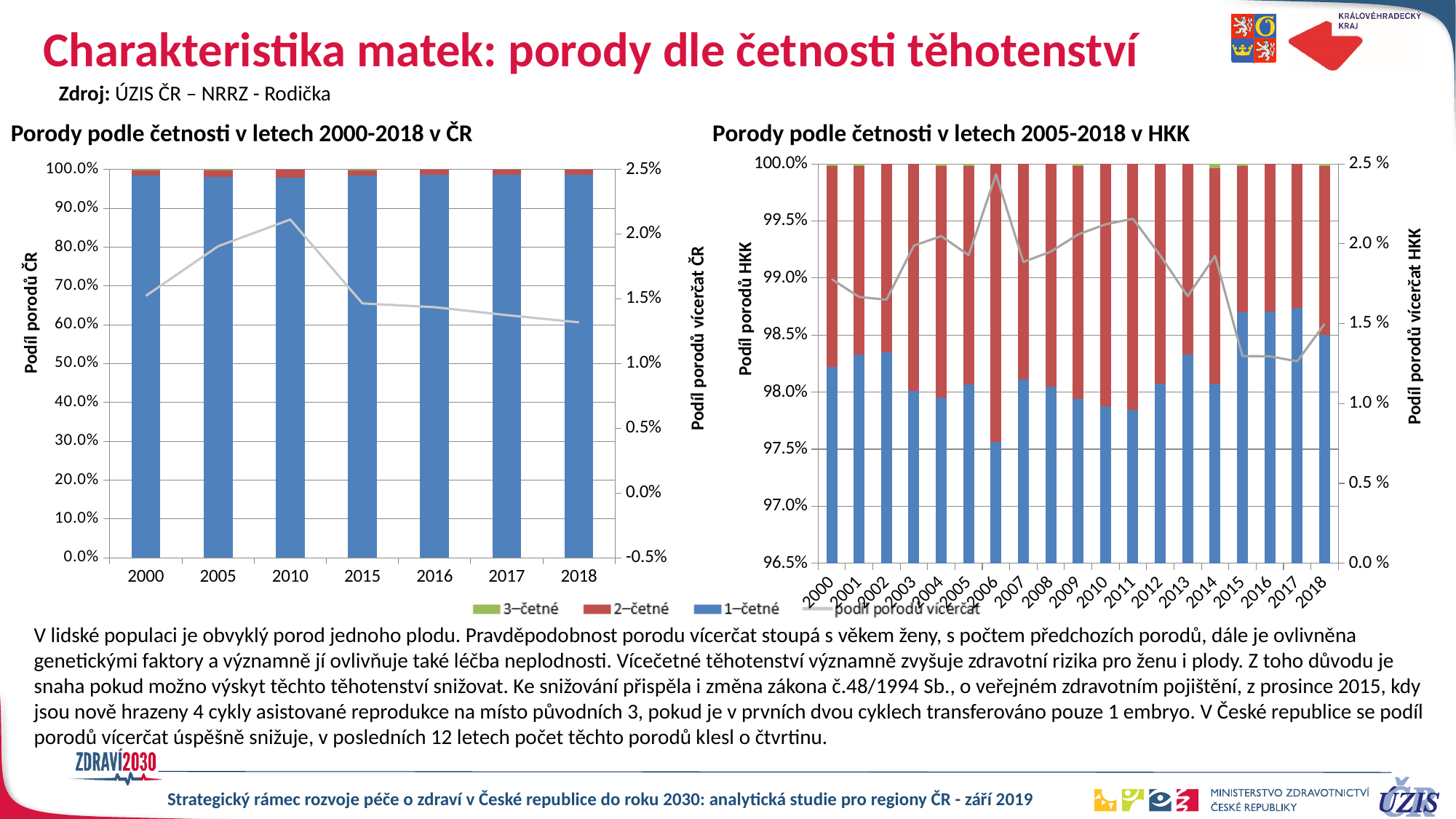
In the left chart 'Porody podle četnosti v letech 2000-2018 v ČR', is the value of the line 'podíl porodů vícerčat' in 2018 greater or less than 1.5%? less How many series does the shared legend below the charts list? 4 In the left chart 'Porody podle četnosti v letech 2000-2018 v ČR', in which year does the line 'podíl porodů vícerčat' reach its highest value? 2010 In the right chart 'Porody podle četnosti v letech 2005-2018 v HKK', is the '1–četné' share in 2006 greater or less than 98.0%? less In the right chart 'Porody podle četnosti v letech 2005-2018 v HKK', in which year does the line 'podíl porodů vícerčat' reach its highest value? 2006 In the right chart 'Porody podle četnosti v letech 2005-2018 v HKK', which is larger, the '1–četné' share in 2017 or in 2006? 2017 In the left chart 'Porody podle četnosti v letech 2000-2018 v ČR', in which year is the line 'podíl porodů vícerčat' lowest? 2018 How many years are shown on the x axis of the right chart 'Porody podle četnosti v letech 2005-2018 v HKK'? 19 What type of chart is the left chart titled 'Porody podle četnosti v letech 2000-2018 v ČR'? Stacked bar chart with a line How many years are shown on the x axis of the left chart 'Porody podle četnosti v letech 2000-2018 v ČR'? 7 In the left chart 'Porody podle četnosti v letech 2000-2018 v ČR', does the line 'podíl porodů vícerčat' rise or fall from 2010 to 2018? fall In the right chart 'Porody podle četnosti v letech 2005-2018 v HKK', is the value of the line 'podíl porodů vícerčat' in 2006 greater or less than 2.0 %? greater